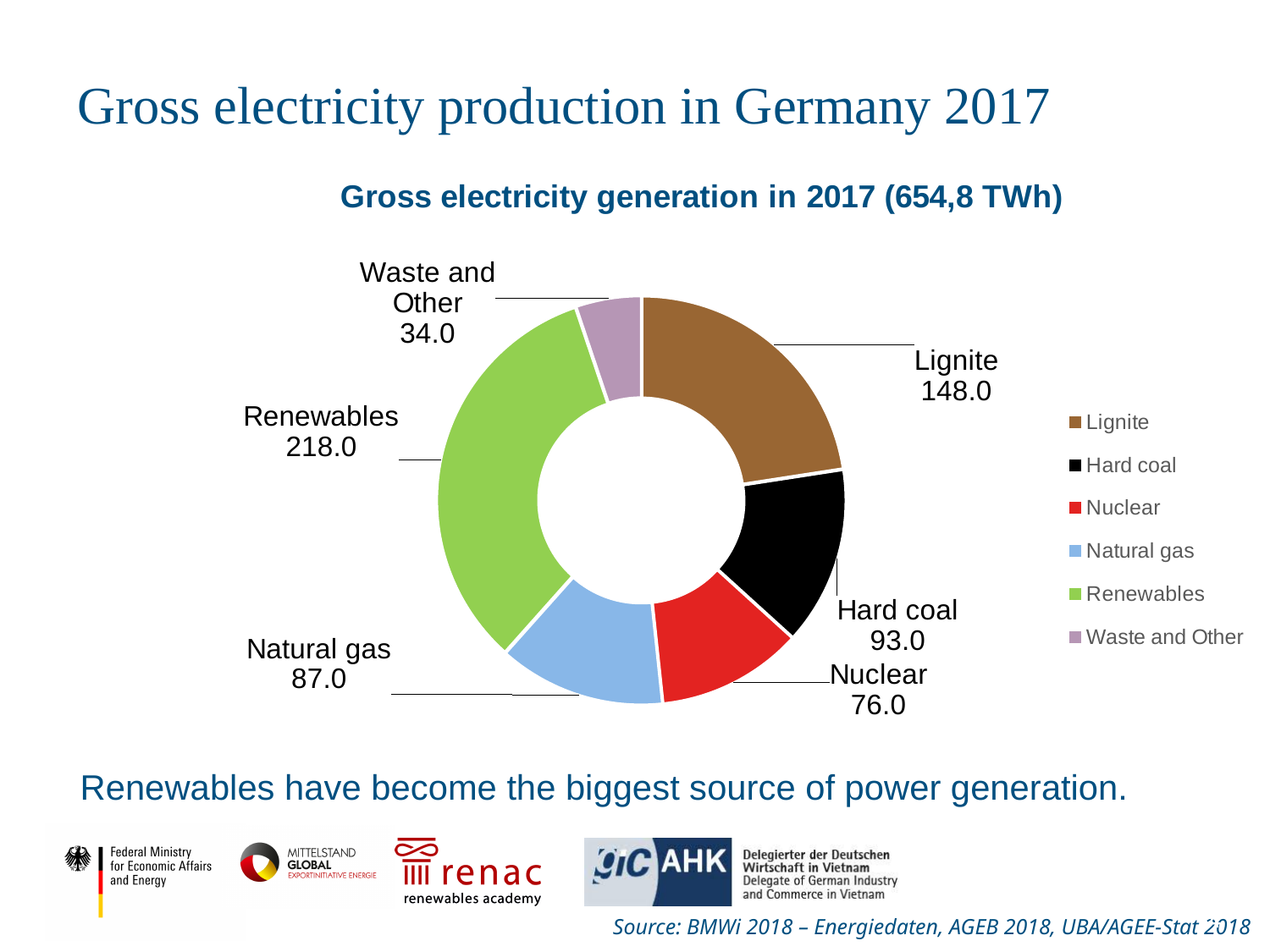
What is the title of the chart? Gross electricity generation in 2017 (654,8 TWh) Which is larger, the value for Natural gas or the value for Hard coal? Hard coal Which category has the smallest value in the chart? Waste and Other What is the difference between the values for Hard coal and Nuclear? 17.0 What is the value for Nuclear in the chart? 76.0 What is the value for Lignite in the chart? 148.0 Which category has the largest value in the chart? Renewables What is the value for Renewables in the doughnut chart? 218.0 What is the difference between the values for Renewables and Lignite? 70.0 What is the value for Waste and Other in the chart? 34.0 What kind of chart is shown on the slide? doughnut chart How many categories are shown in the chart? 6